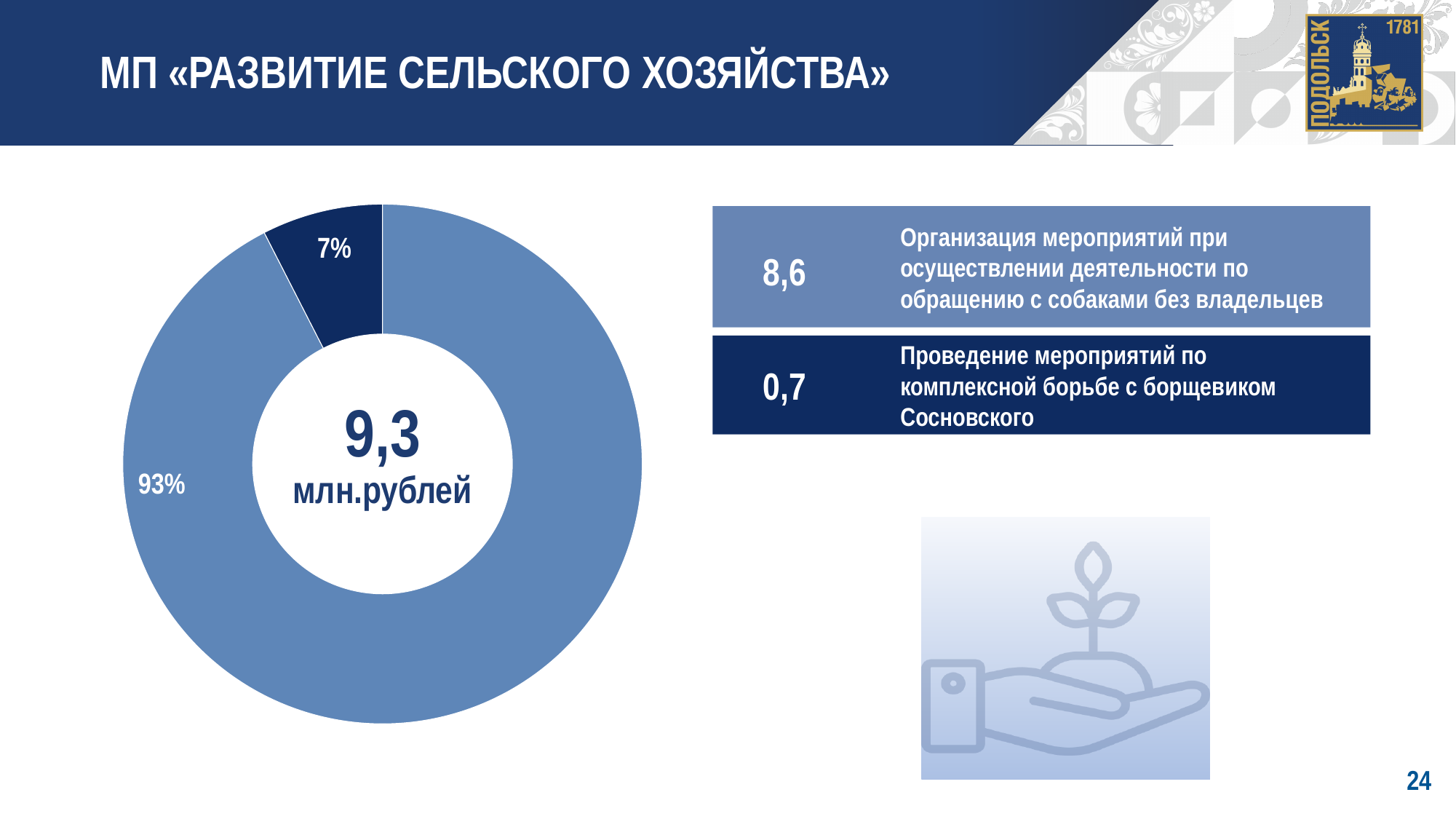
What is the difference between the 93% slice and the 7% slice, in percentage points? 86 What colour is the 7% slice of the donut chart? Dark blue What is the difference between the values 8,6 and 0,7 shown on the slide? 7,9 What share of the donut chart does the larger slice represent? 93% How many slices does the donut chart have? 2 What total value is shown in the centre of the donut chart? 9,3 млн.рублей What value is shown for «Организация мероприятий при осуществлении деятельности по обращению с собаками без владельцев»? 8,6 What value is shown for «Проведение мероприятий по комплексной борьбе с борщевиком Сосновского»? 0,7 Which item has the highest value: the dog-related activities (собаки без владельцев) or the hogweed control (борщевик Сосновского)? Организация мероприятий при осуществлении деятельности по обращению с собаками без владельцев What share of the donut chart does the smaller slice represent? 7% What kind of chart is shown on the slide? Pie (donut) chart Which item has the lowest value on the slide? Проведение мероприятий по комплексной борьбе с борщевиком Сосновского